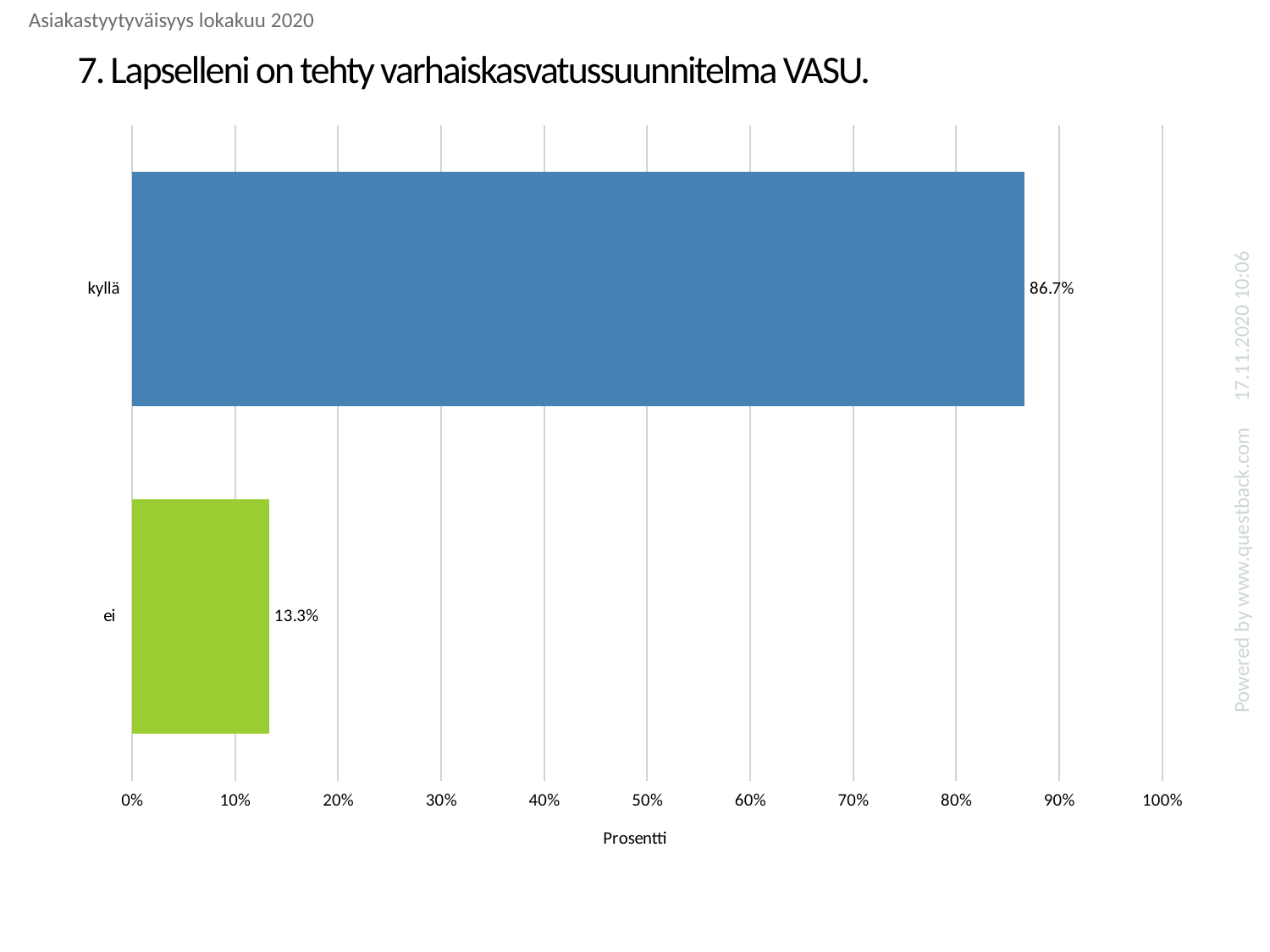
What is the value for "kyllä"? 86.7% How many categories are shown in the chart? 2 Which category has the lowest value? ei Which is larger, the value for "kyllä" or the value for "ei"? kyllä What is the difference between the values for "kyllä" and "ei"? 73.4% What kind of chart is shown on the slide? bar chart Which category has the highest value? kyllä Is the value for "ei" greater or less than 20%? less What is the label of the horizontal axis? Prosentti What is the value for "ei"? 13.3% What colour is the bar for "ei"? green Is the value for "kyllä" greater or less than 80%? greater